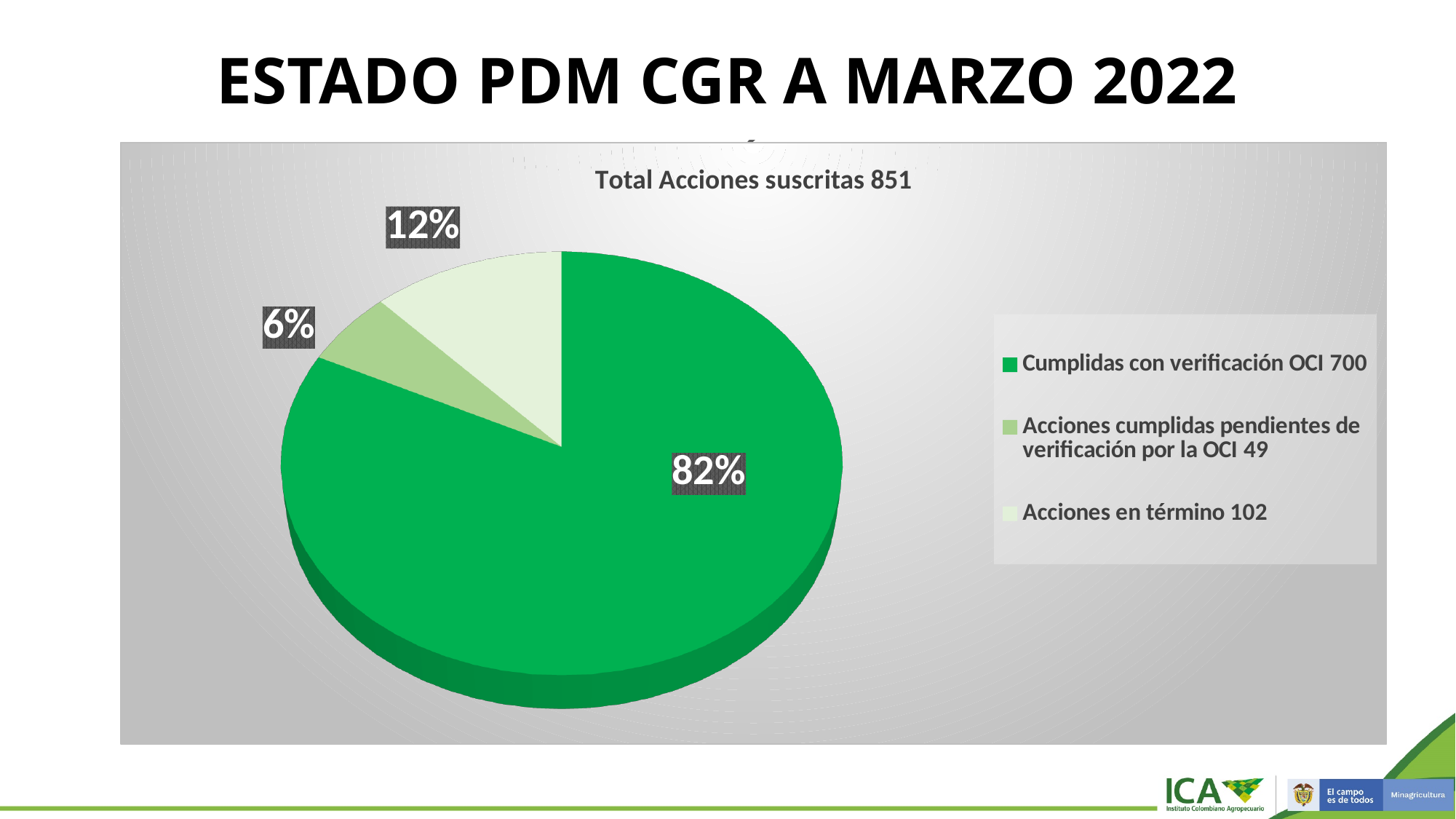
What percentage share does the slice for "Acciones cumplidas pendientes de verificación por la OCI" have? 6% What percentage share does the slice for "Cumplidas con verificación OCI" have? 82% What percentage share does the slice for "Acciones en término" have? 12% Which category has the smallest slice of the pie? Acciones cumplidas pendientes de verificación por la OCI What total number of actions does the chart title state? 851 How many entries does the legend list? 3 Which is larger: the share for "Acciones en término" or the share for "Acciones cumplidas pendientes de verificación por la OCI"? Acciones en término How many slices does the pie chart have? 3 What is the difference in percentage points between the "Cumplidas con verificación OCI" slice and the "Acciones en término" slice? 70 percentage points According to the legend, how many actions are "Acciones en término"? 102 What kind of chart is shown on the slide? Pie chart Which category has the largest slice of the pie? Cumplidas con verificación OCI